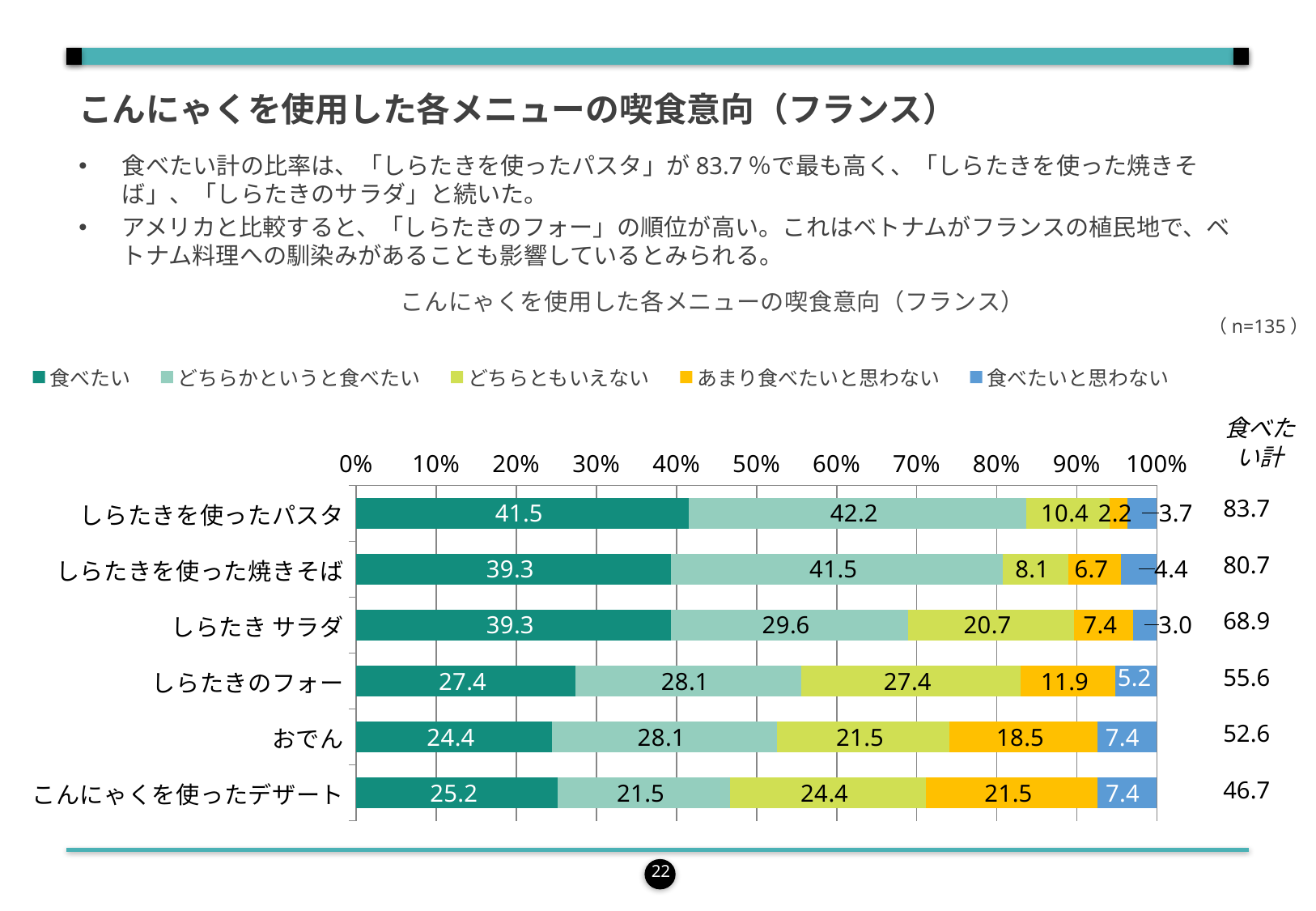
Which menu item has the lowest 食べたい計 value? こんにゃくを使ったデザート What is the value of 食べたい for しらたきを使ったパスタ? 41.5 Which menu item has the highest 食べたい value? しらたきを使ったパスタ What kind of chart is shown on the slide? Stacked bar chart How many series does the legend list? 5 What is the value of あまり食べたいと思わない for おでん? 18.5 Which is larger: the 食べたいと思わない value for しらたきのフォー or for おでん? おでん What is the value of どちらかというと食べたい for しらたきを使った焼きそば? 41.5 What is the difference between the 食べたい計 values for しらたきを使ったパスタ and しらたきを使った焼きそば? 3.0 How many menu items are shown in the chart? 6 What is the sample size (n) shown for the chart? n=135 What is the value of どちらともいえない for しらたき サラダ? 20.7